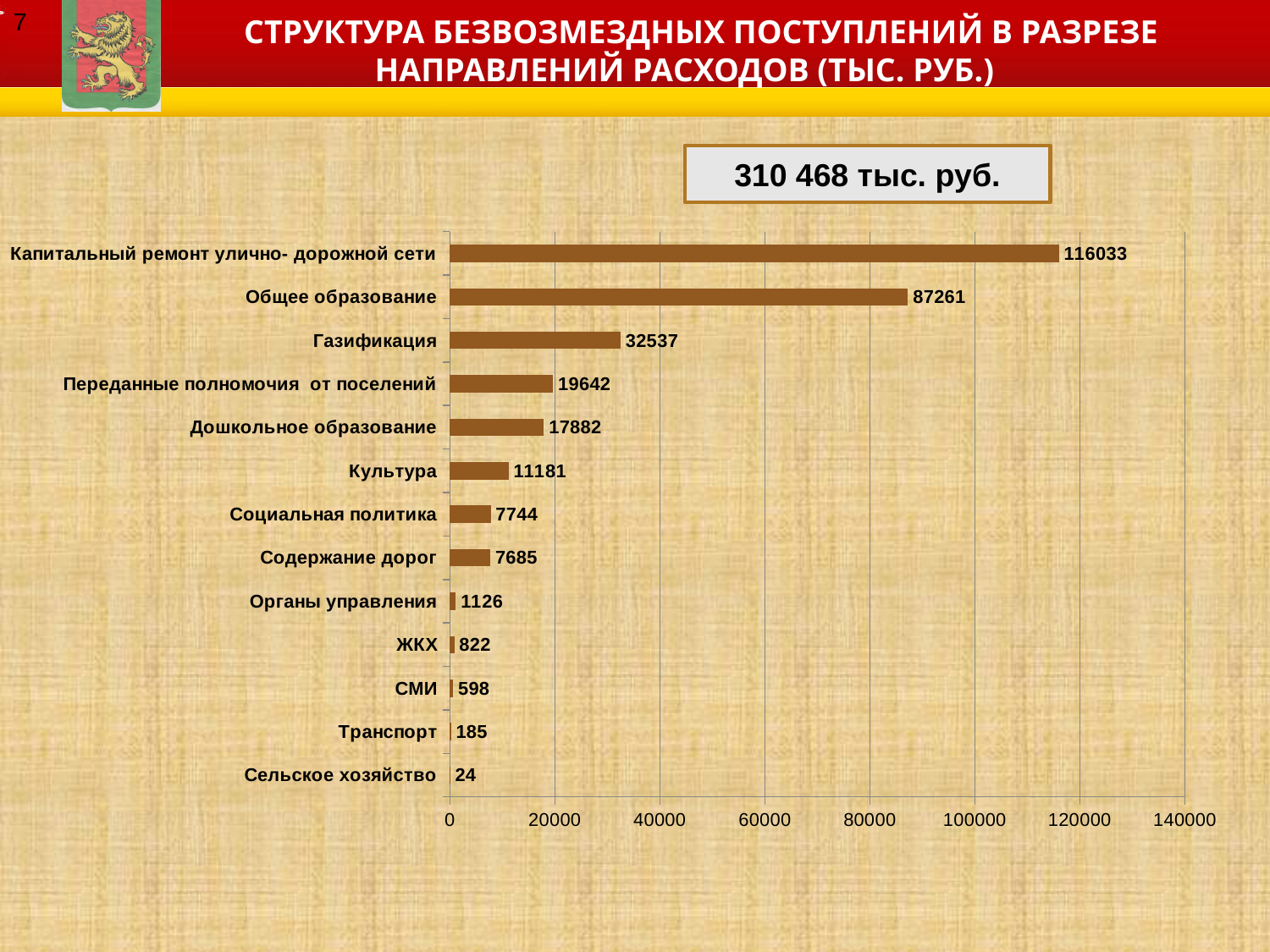
How many categories are shown in the chart? 13 What is the value for Капитальный ремонт улично-дорожной сети? 116033 What is the value for Транспорт? 185 What is the value for Культура? 11181 Is the value for Общее образование greater or less than 80000? greater Which is larger, Переданные полномочия от поселений or Дошкольное образование? Переданные полномочия от поселений Which category has the highest value? Капитальный ремонт улично-дорожной сети Which category has the lowest value? Сельское хозяйство What is the value for Газификация? 32537 What total amount is shown in the box above the chart? 310 468 тыс. руб. What kind of chart is shown on the slide? bar chart What is the difference between Общее образование and Дошкольное образование? 69379